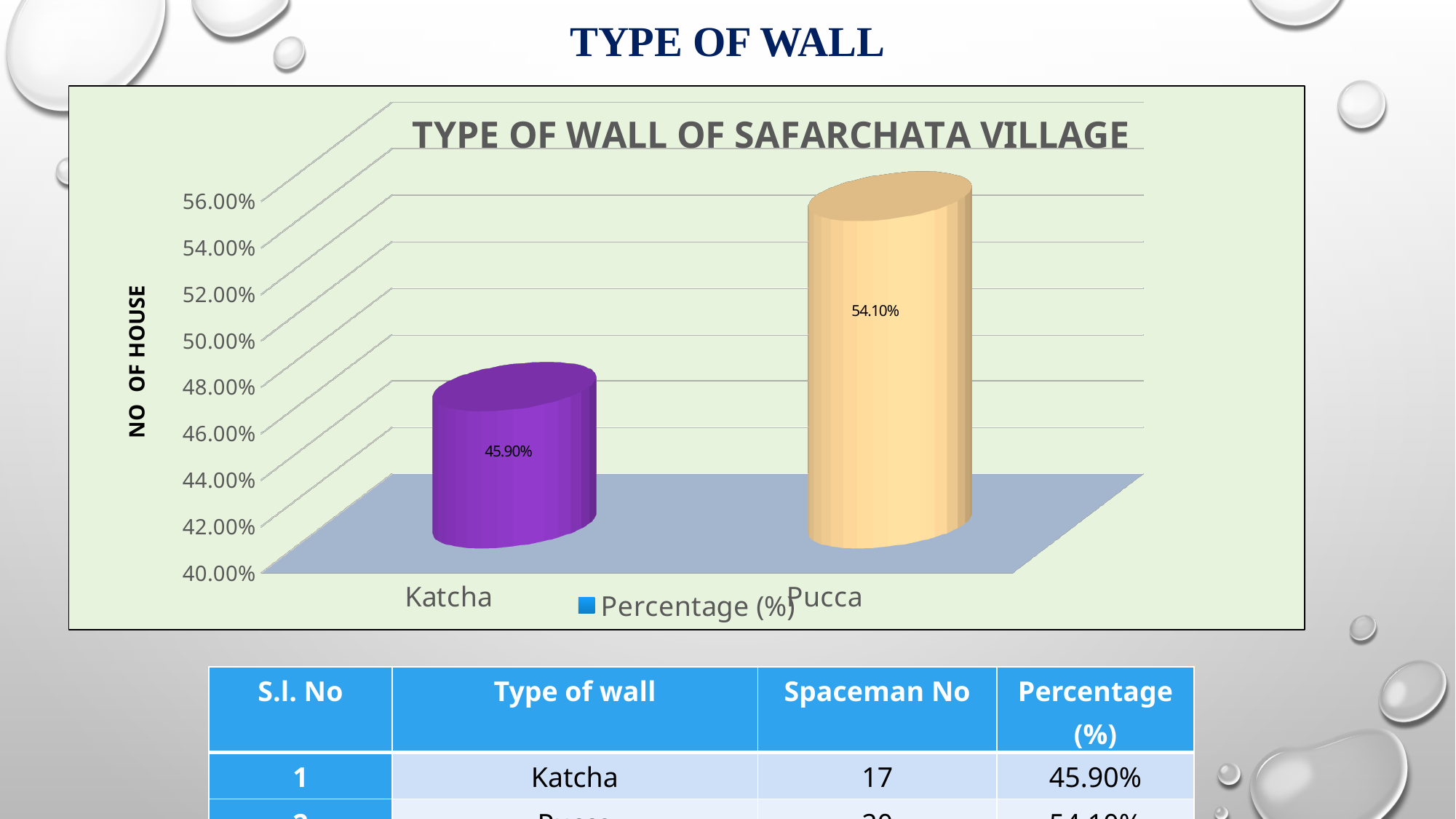
What is the title of the chart? TYPE OF WALL OF SAFARCHATA VILLAGE What is the difference between the values for Pucca and Katcha? 8.20% Is the value for Pucca greater or less than 52.00%? greater Is the value for Katcha greater or less than 50.00%? less What is the value for Pucca? 54.10% What kind of chart is shown? bar chart How many series does the legend list? 1 How many categories are shown on the x axis? 2 Which category has the highest value? Pucca What is the value for Katcha? 45.90% Which is larger, the value for Katcha or the value for Pucca? Pucca Which category has the lowest value? Katcha